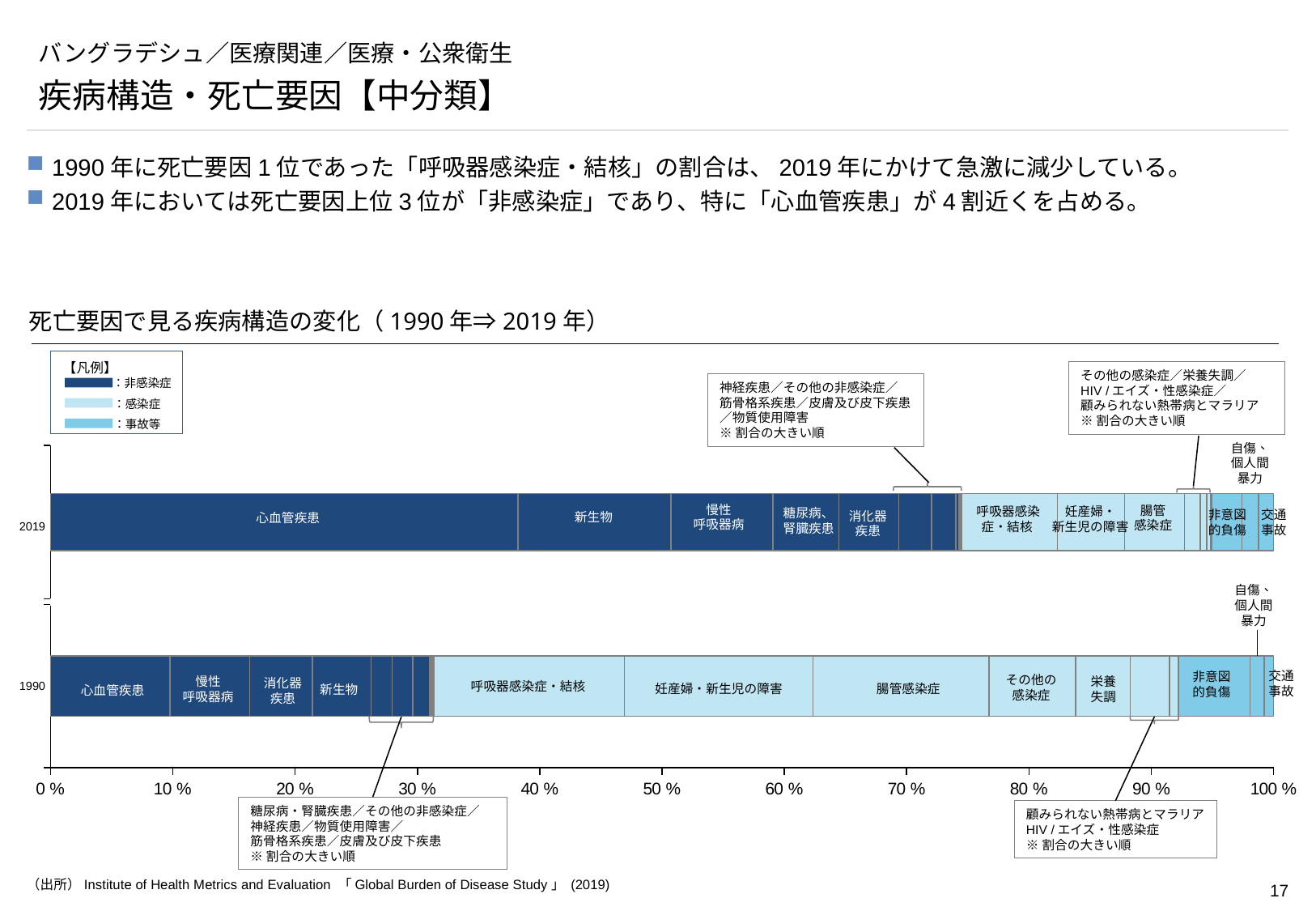
Did the share of 呼吸器感染症・結核 rise or fall from 1990 to 2019? fall Which cause of death has the largest share in the 2019 bar? 心血管疾患 How many categories does the legend (凡例) list? 3 Which year has the larger share for 心血管疾患, 1990 or 2019? 2019 Is the share of 心血管疾患 in 1990 greater or less than 20%? less Which year has the larger share for 腸管感染症, 1990 or 2019? 1990 What kind of chart is shown on the slide? Stacked bar chart According to the legend, what does the dark blue colour represent? 非感染症 Which cause of death has the largest share in the 1990 bar? 呼吸器感染症・結核 Is the share of 心血管疾患 in 2019 greater or less than 30%? greater How many bars (years) does the chart compare? 2 Is the share of 呼吸器感染症・結核 in 1990 greater or less than 10%? greater